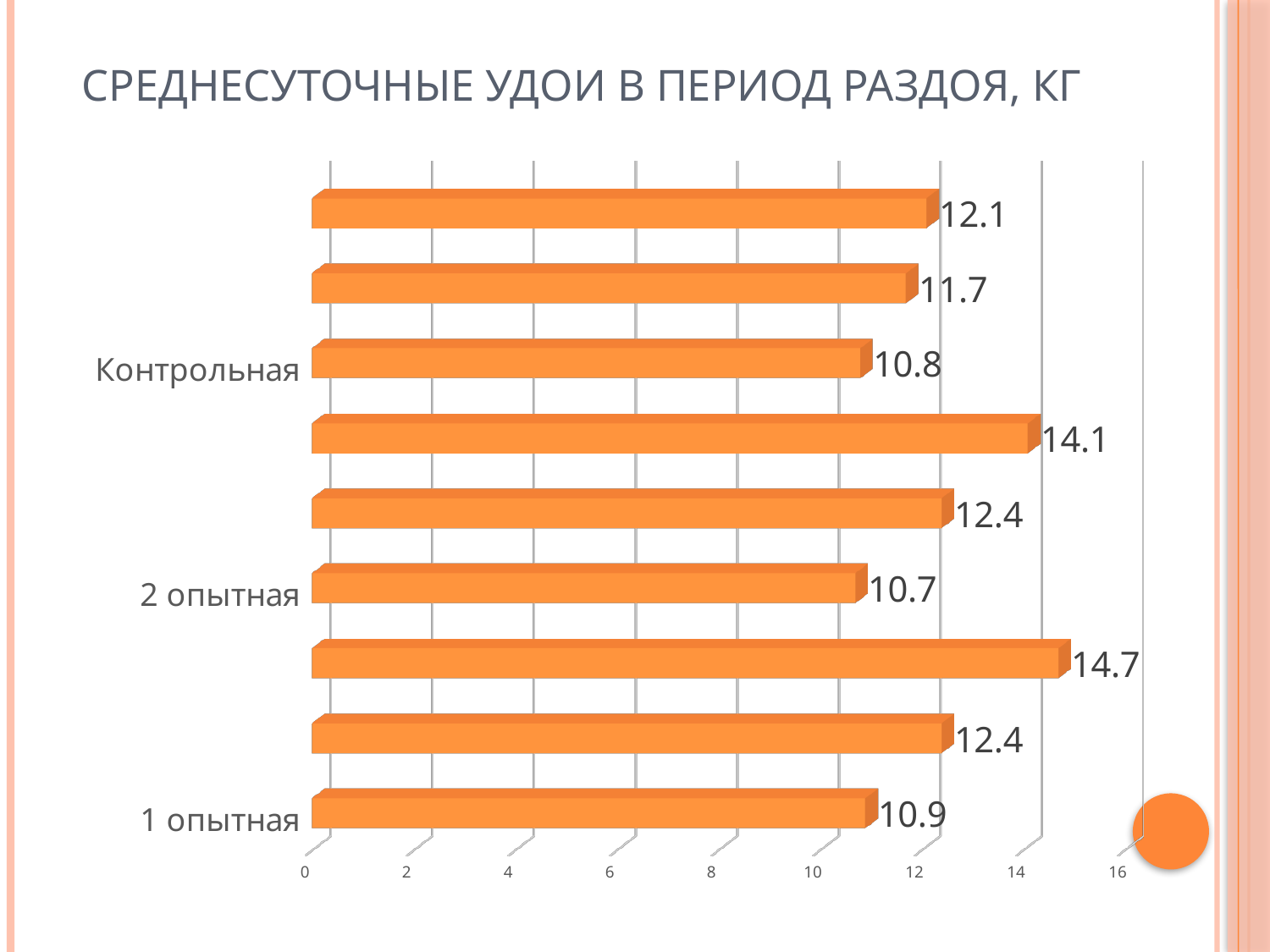
What is the highest value labelled on any bar in the chart? 14.7 What is the lowest value labelled on any bar in the chart? 10.7 What is the largest value among the bars for the Контрольная group? 12.1 What is the title of the chart? СРЕДНЕСУТОЧНЫЕ УДОИ В ПЕРИОД РАЗДОЯ, КГ What is the largest value among the bars for the 2 опытная group? 14.1 What kind of chart is shown on the slide? Bar chart Which group has the longer top bar: 1 опытная or Контрольная? 1 опытная How many bars are plotted in total on the chart? 9 What is the difference between the largest bar of the 1 опытная group (14.7) and the largest bar of the 2 опытная group (14.1)? 0.6 How many categories (groups) are labelled on the vertical axis of the chart? 3 What is the smallest value among the bars for the Контрольная group? 10.8 Is the value of the longest bar for the 1 опытная group greater or less than 14? greater